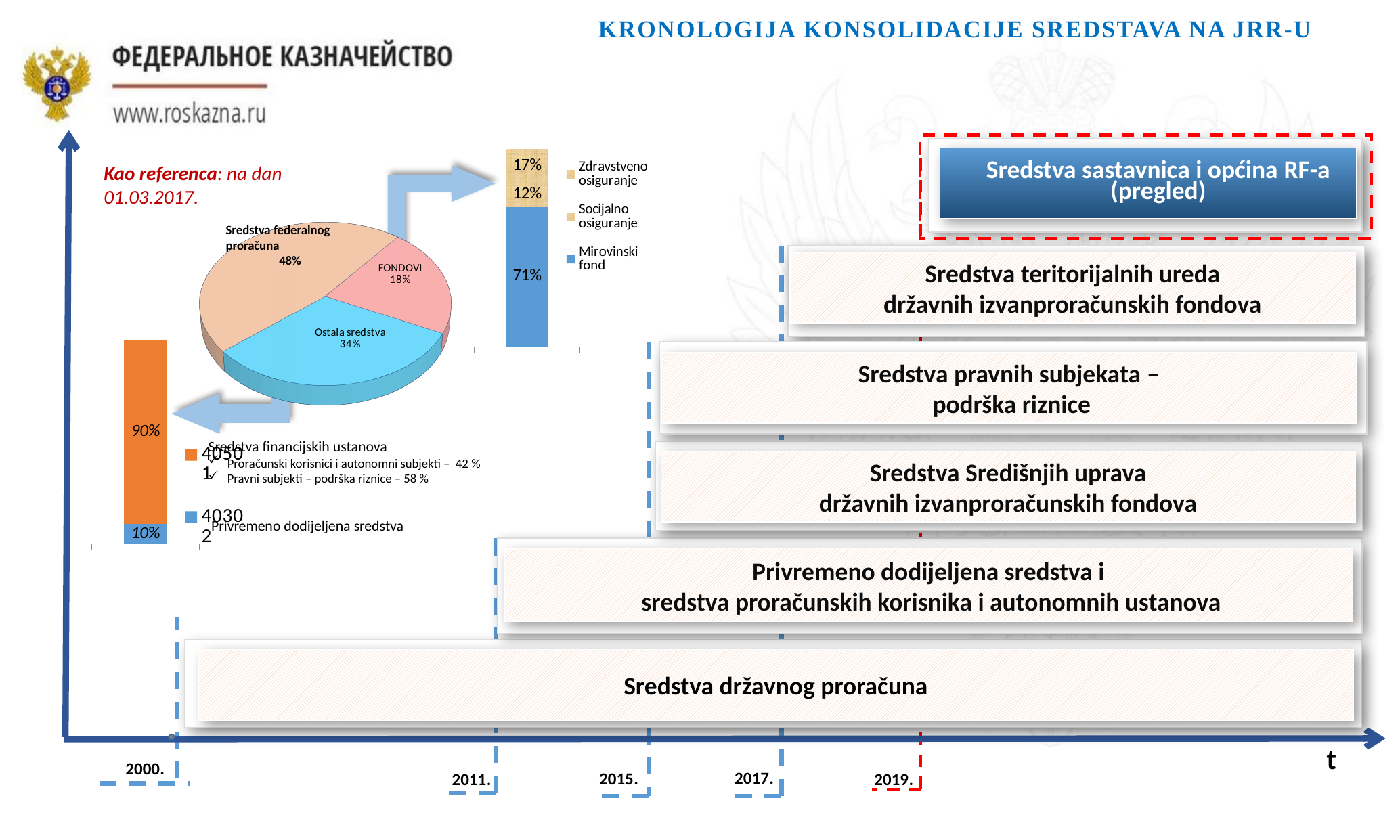
In the pie chart, which slice is the largest? Sredstva federalnog proračuna In the stacked bar chart at the top right (next to the pie), what value is shown for Zdravstveno osiguranje? 17% In the pie chart, how many slices are there? 3 In the stacked bar chart at the top right (next to the pie), which segment is the smallest? Socijalno osiguranje In the stacked bar chart at the left of the slide, what value is shown for the orange segment? 90% In the stacked bar chart at the top right (next to the pie), how many series does the legend list? 3 In the pie chart, what share is labelled for Ostala sredstva? 34% In the pie chart, what share is labelled for Sredstva federalnog proračuna? 48% In the stacked bar chart at the top right (next to the pie), what value is shown for Mirovinski fond? 71% In the pie chart, what is the difference in percentage points between Sredstva federalnog proračuna and Ostala sredstva? 14 In the pie chart, which slice is the smallest? FONDOVI In the pie chart, what share is labelled for FONDOVI? 18%